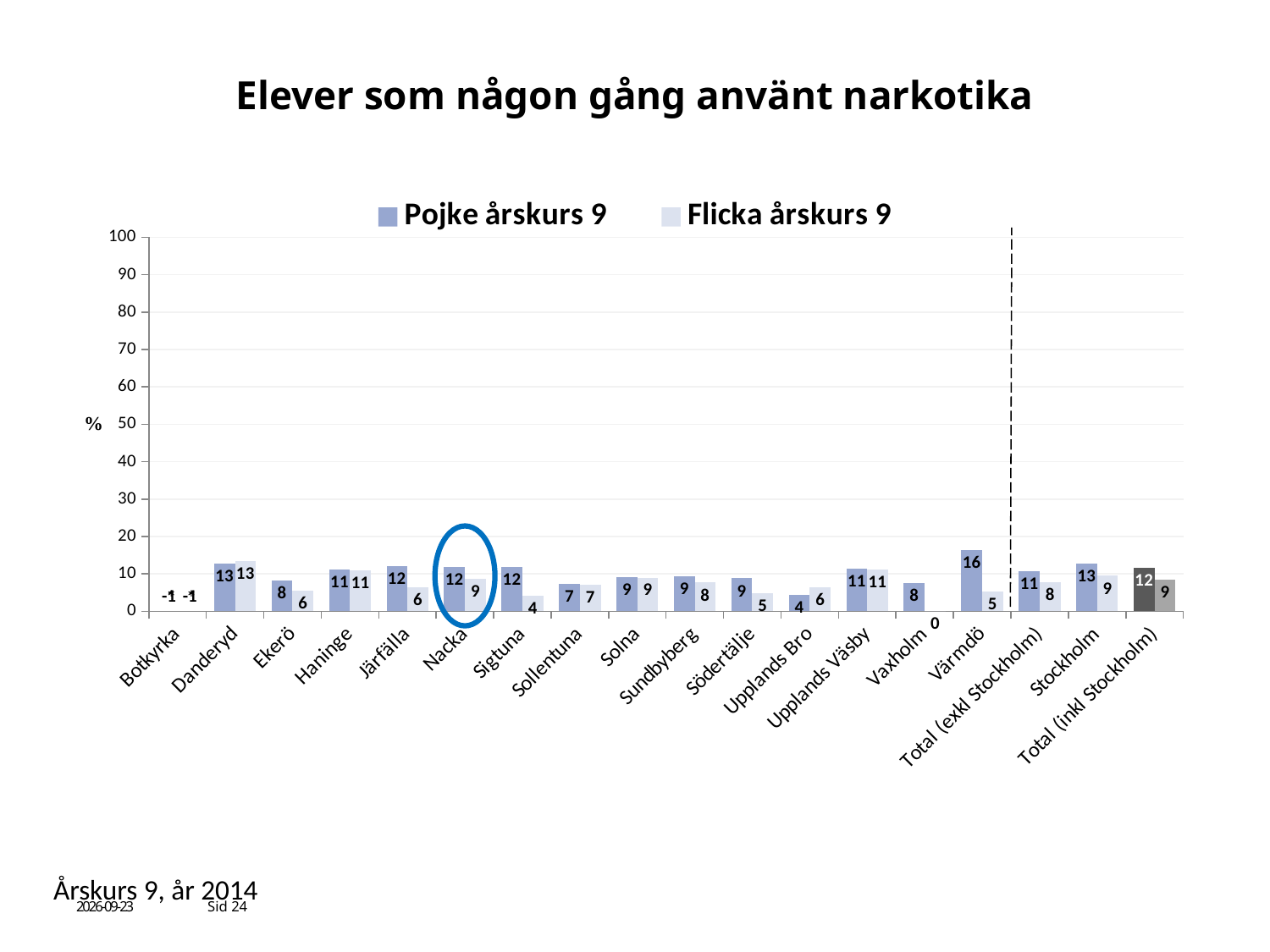
What is the value for Pojke årskurs 9 in Värmdö? 16 Is the value for Pojke årskurs 9 in Danderyd greater or less than 10? greater What is the value for Flicka årskurs 9 in Sigtuna? 4 What kind of chart is shown on the slide? Bar chart What is the value for Flicka årskurs 9 in Vaxholm? 0 Which municipality has the highest value for Pojke årskurs 9? Värmdö What is the difference between the Pojke årskurs 9 values for Stockholm and Total (exkl Stockholm)? 2 What is the difference between the Pojke årskurs 9 and Flicka årskurs 9 values in Värmdö? 11 Which is larger in Upplands Bro, the Pojke årskurs 9 value or the Flicka årskurs 9 value? Flicka årskurs 9 What is the value for Pojke årskurs 9 in Total (inkl Stockholm)? 12 How many series does the legend list? 2 How many categories are shown on the x axis? 18